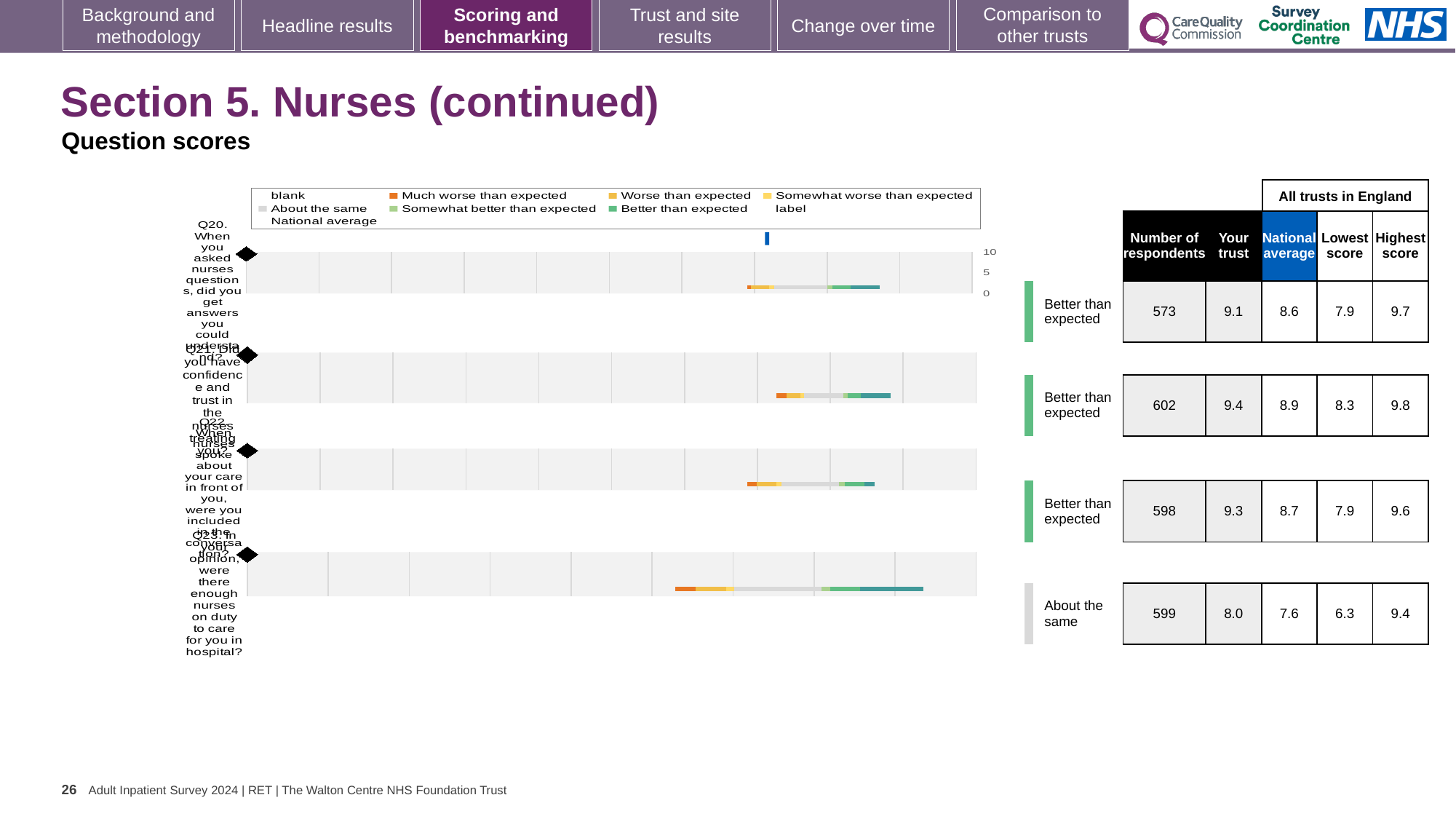
Which has the larger 'Your trust' score, Q20 or Q21? Q21 Which question has the lowest national average score? Q23 What is the 'Your trust' score for Q23? 8.0 Which question has the highest 'Your trust' score? Q21 What is the national average score for Q20? 8.6 Which question is rated 'About the same' rather than 'Better than expected'? Q23 What kind of chart is used to show the question scores? bar chart How many survey questions (Q20 to Q23) are plotted on the chart? 4 What is the highest score among all trusts in England for Q23? 9.4 What is the lowest score among all trusts in England for Q21? 8.3 What is the number of respondents for Q21? 602 What is the difference between the 'Your trust' score and the national average for Q22? 0.6